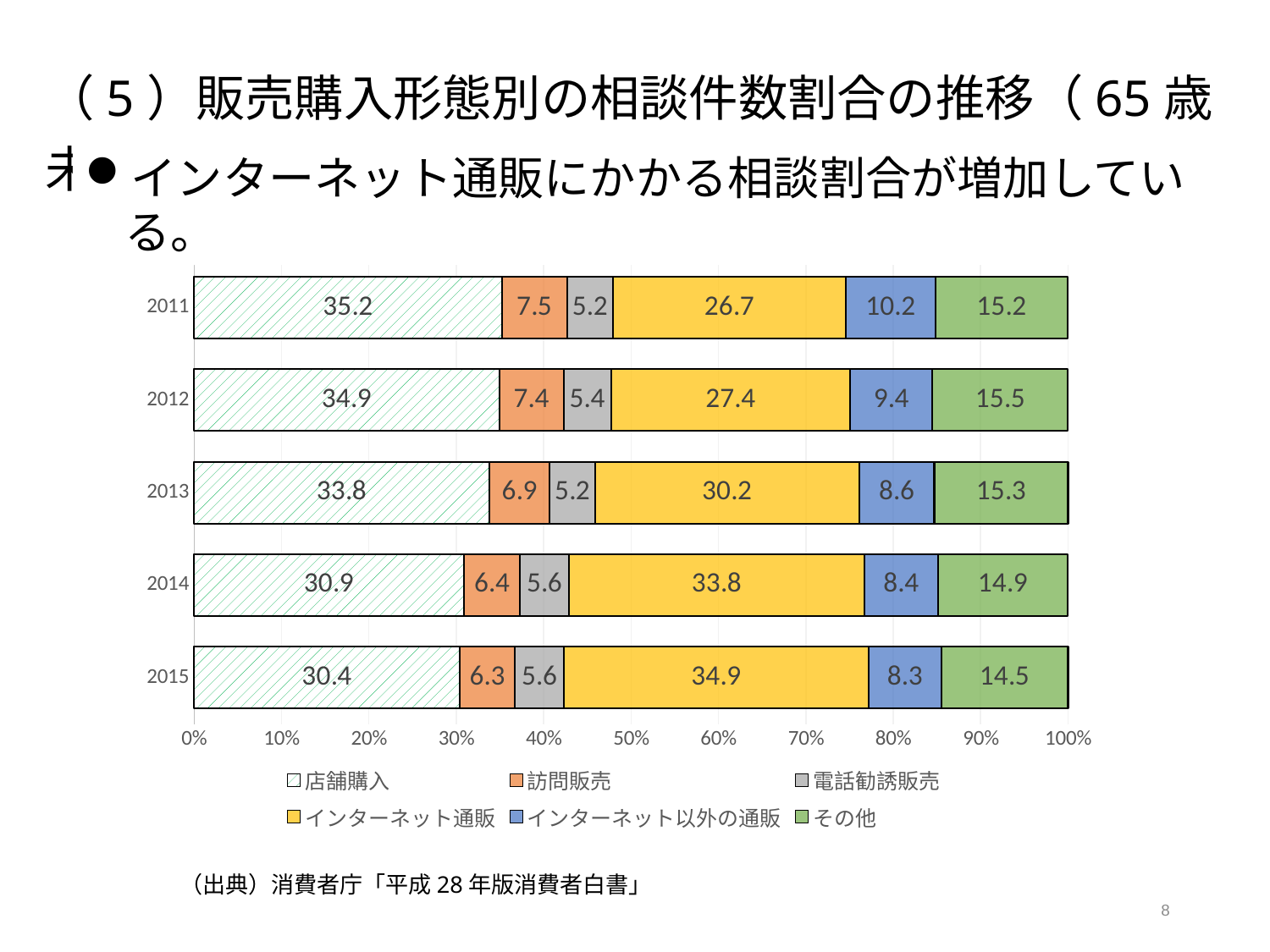
In which year is the value for インターネット通販 the highest? 2015 In which year is the value for 店舗購入 the lowest? 2015 Does the value for インターネット通販 rise or fall from 2011 to 2015? rise How many series does the legend list? 6 What kind of chart is shown on the slide? stacked bar chart What is the value for インターネット通販 in 2015? 34.9 Which series is shown in yellow? インターネット通販 What is the value for 店舗購入 in 2011? 35.2 What is the value for インターネット以外の通販 in 2012? 9.4 What is the difference between the インターネット通販 value in 2015 and in 2011? 8.2 In 2013, which is larger: 店舗購入 or インターネット通販? 店舗購入 How many years are shown in the chart? 5